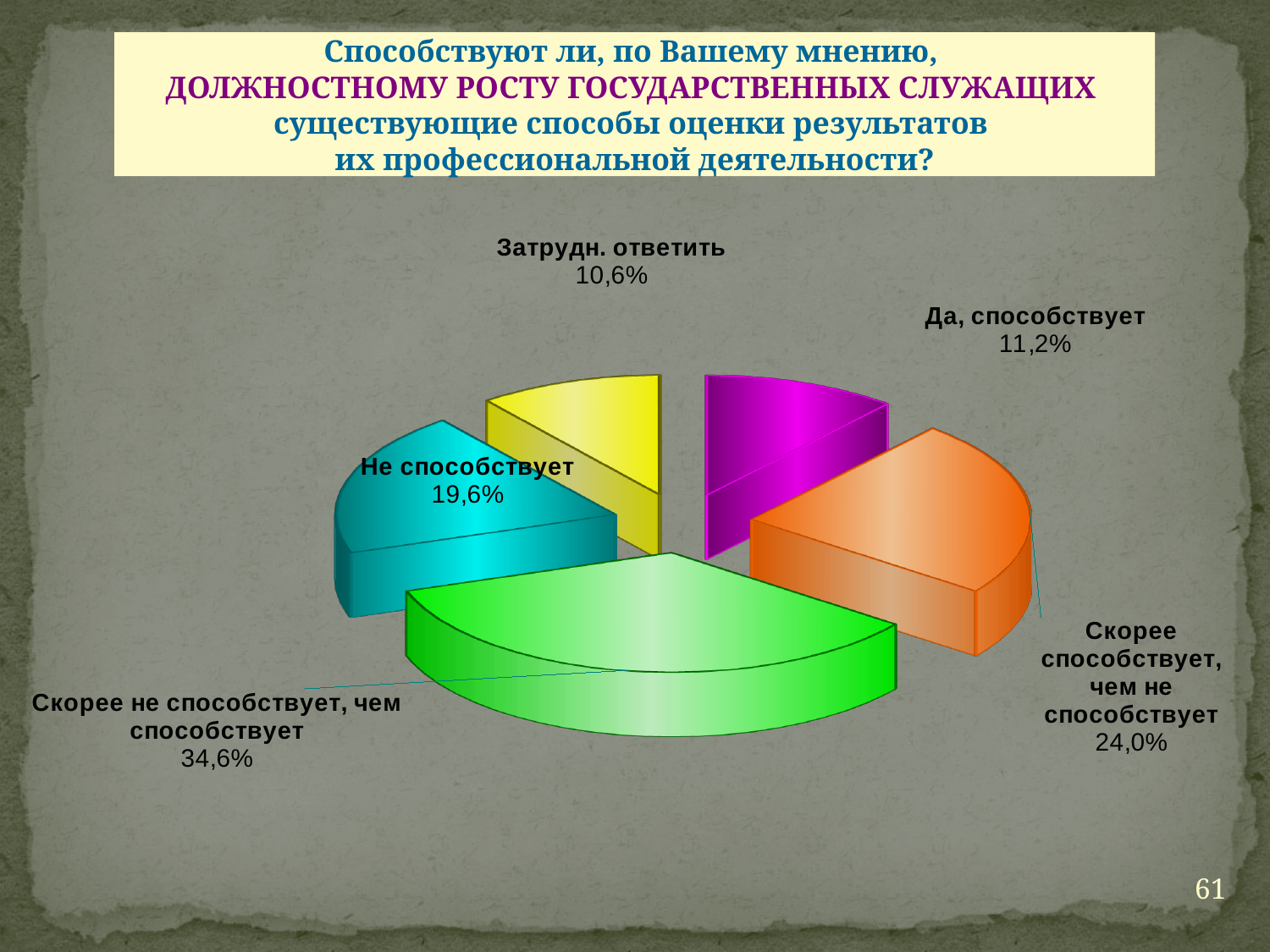
Which is larger: "Не способствует" or "Скорее способствует, чем не способствует"? Скорее способствует, чем не способствует What colour is the slice for "Не способствует"? cyan (blue-green) Which category has the smallest share of the pie? Затрудн. ответить What is the value for "Затрудн. ответить"? 10,6% How many slices does the pie chart have? 5 What kind of chart is shown on the slide? pie chart What is the combined share of "Да, способствует" and "Скорее способствует, чем не способствует"? 35,2% What is the value for "Скорее не способствует, чем способствует"? 34,6% What is the value for "Не способствует"? 19,6% Which category has the largest share of the pie? Скорее не способствует, чем способствует What is the value for "Да, способствует"? 11,2% What is the difference between "Скорее не способствует, чем способствует" and "Скорее способствует, чем не способствует"? 10,6%